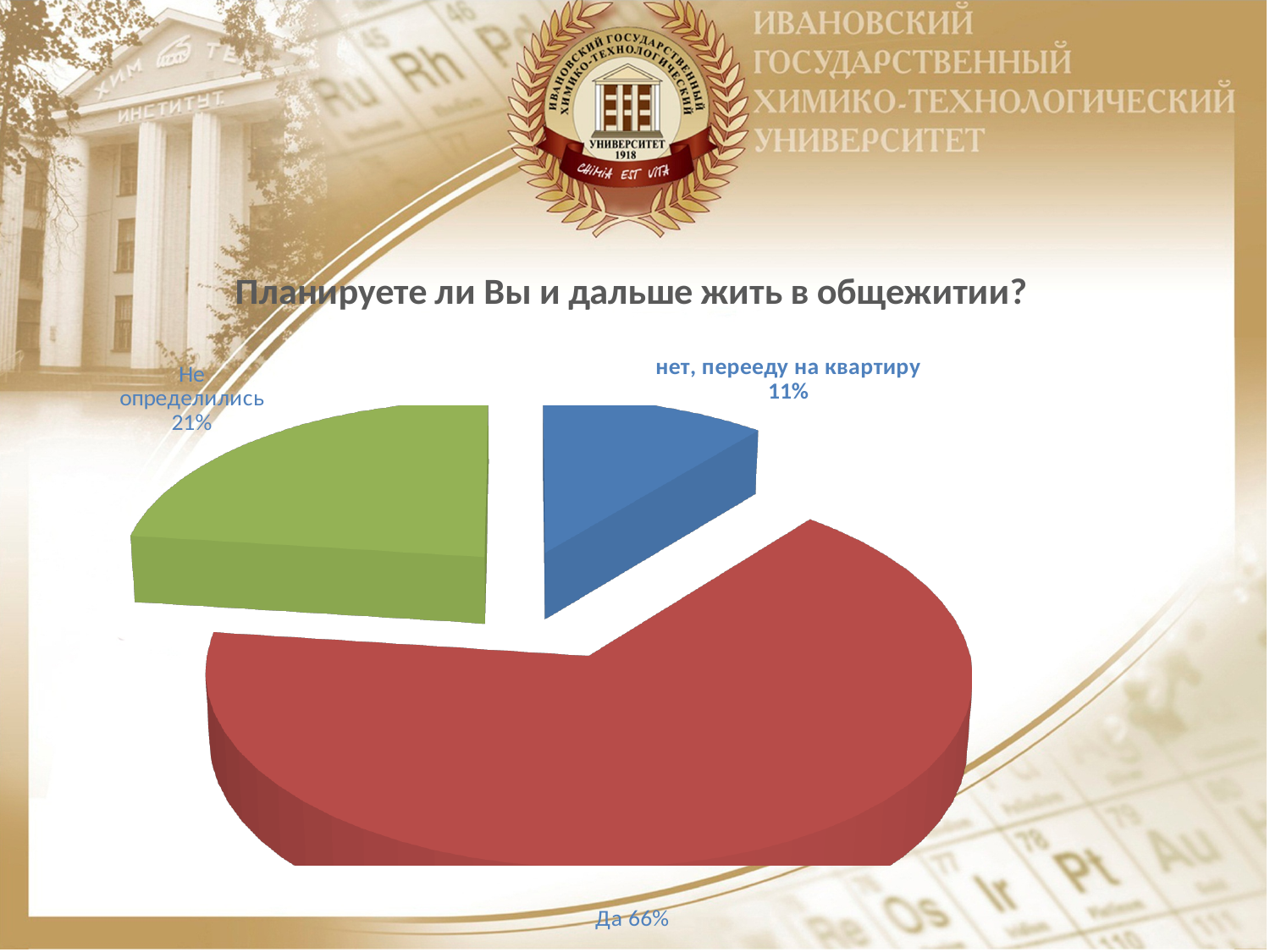
What kind of chart is shown on the slide? pie chart What colour is the "Да" slice of the pie? red Which slice of the pie is the largest? Да What is the title of the chart? Планируете ли Вы и дальше жить в общежитии? What is the difference in percentage points between the "Да" slice and the "Не определились" slice? 45 Which slice of the pie is the smallest? нет, перееду на квартиру Which is larger: the share for "Не определились" or the share for "нет, перееду на квартиру"? Не определились How many slices does the pie chart have? 3 What share of the pie is labelled "Да"? 66% What is the difference in percentage points between the "Не определились" slice and the "нет, перееду на квартиру" slice? 10 What share of the pie is labelled "нет, перееду на квартиру"? 11% What share of the pie is labelled "Не определились"? 21%